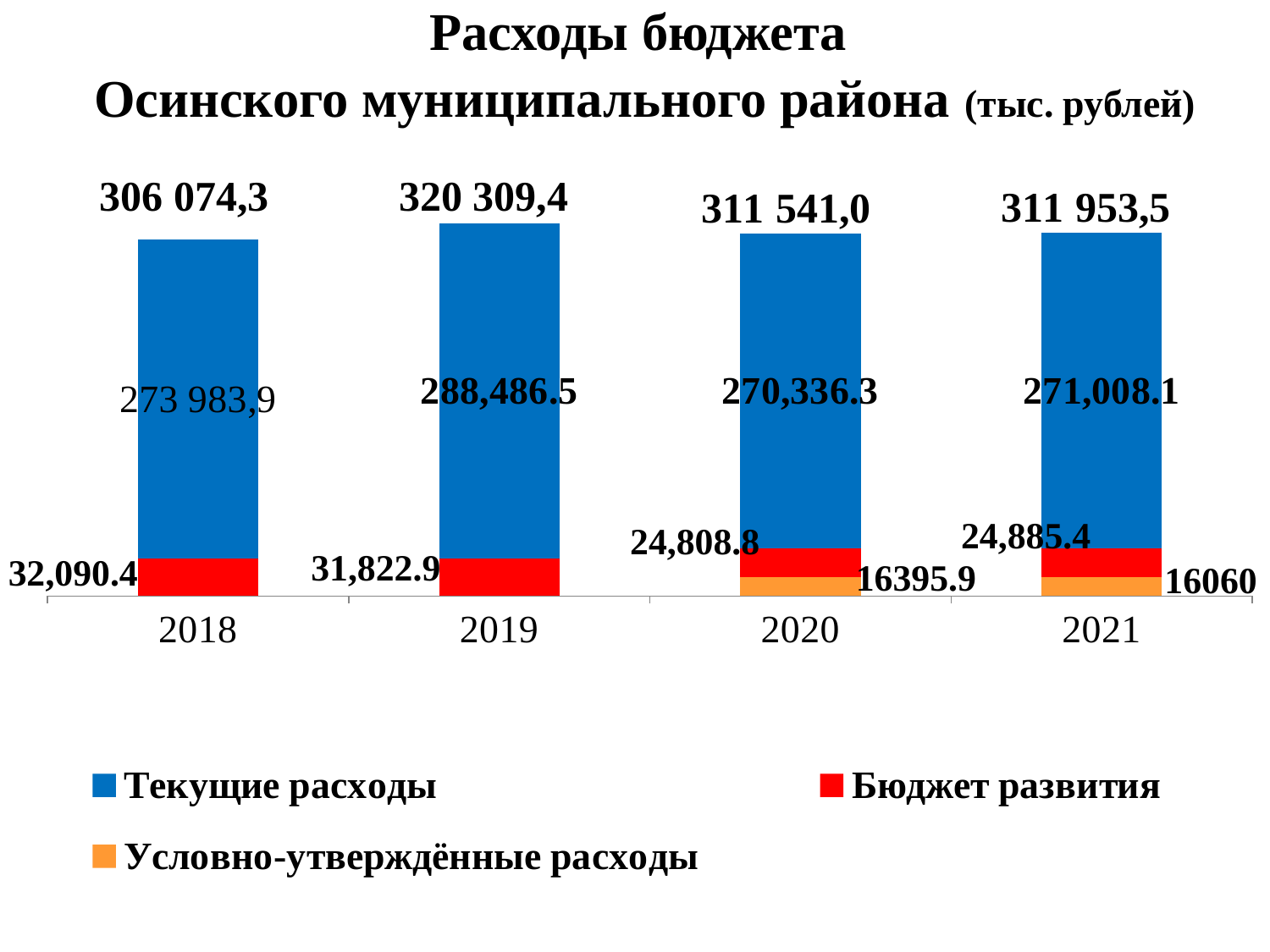
What is the value of Бюджет развития for 2018? 32,090.4 What is the total budget expenditure shown for 2020? 311 541,0 What is the value of Условно-утверждённые расходы for 2021? 16060 What type of chart is shown on the slide? bar chart Which is larger, Текущие расходы in 2018 or in 2019? 2019 How many series does the legend list? 3 Which year has the lowest total budget expenditure? 2018 What is the difference between Бюджет развития in 2021 and in 2020? 76.6 Which year has the highest total budget expenditure? 2019 Which colour represents Условно-утверждённые расходы in the chart? orange How many years are shown on the x axis of the chart? 4 What is the value of Текущие расходы for 2019? 288,486.5